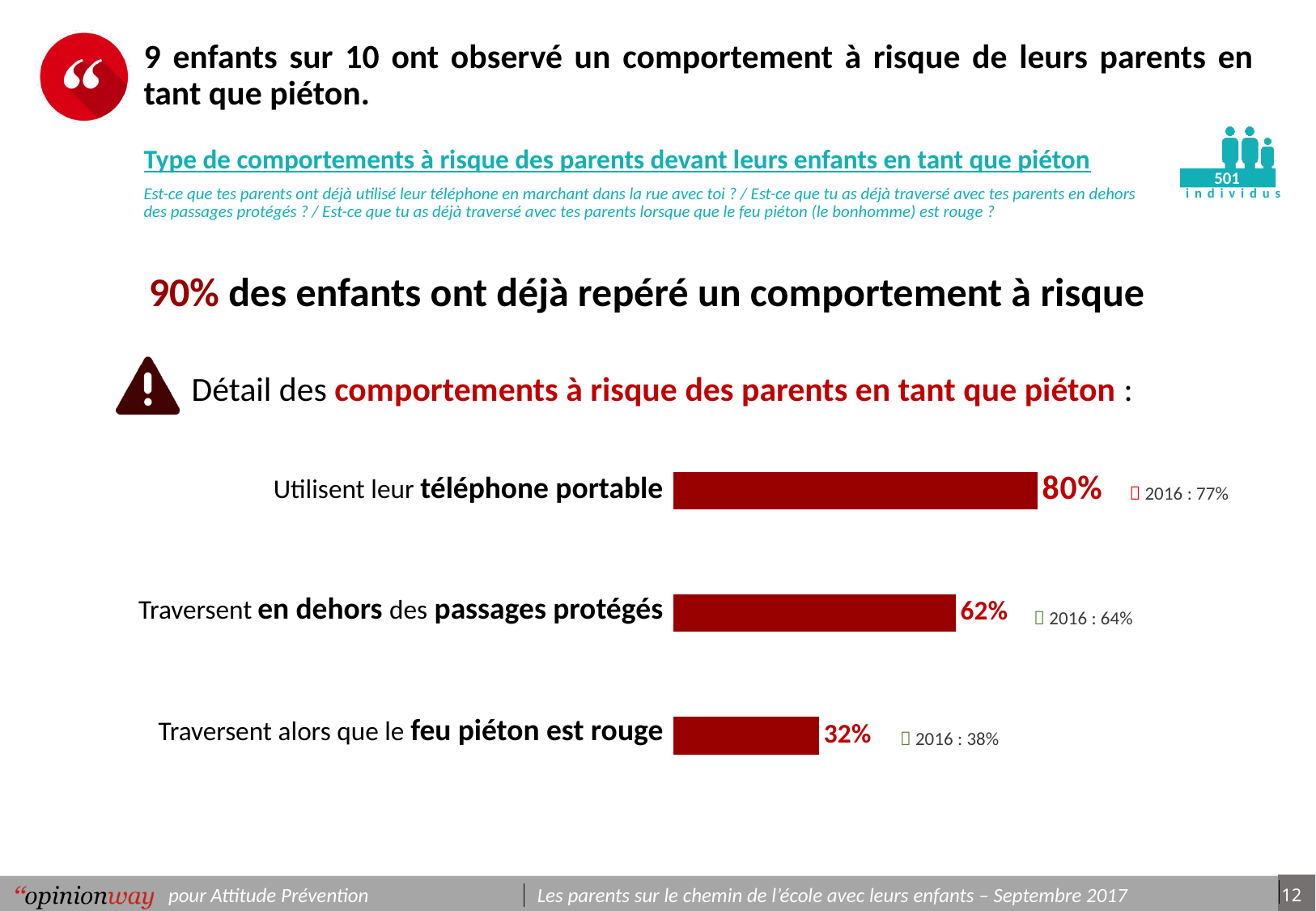
What was the 2016 value shown next to the 'téléphone portable' bar? 77% What kind of chart is used to show the risky behaviours? Bar chart What is the difference between the value for crossing outside protected crossings and the value for crossing at a red pedestrian light? 30 percentage points Which risky behaviour has the lowest percentage? Traversent alors que le feu piéton est rouge What is the difference between the value for using a mobile phone and the value for crossing when the pedestrian light is red? 48 percentage points What percentage of children say their parents use their mobile phone (téléphone portable) while walking? 80% Which is larger: the value for using a mobile phone or the value for crossing outside protected crossings? Utilisent leur téléphone portable What is the value for 'Traversent alors que le feu piéton est rouge'? 32% Which risky behaviour has the highest percentage? Utilisent leur téléphone portable How many risky behaviours are shown as bars in the chart? 3 What was the 2016 value shown next to the 'feu piéton est rouge' bar? 38% What is the value for 'Traversent en dehors des passages protégés'? 62%